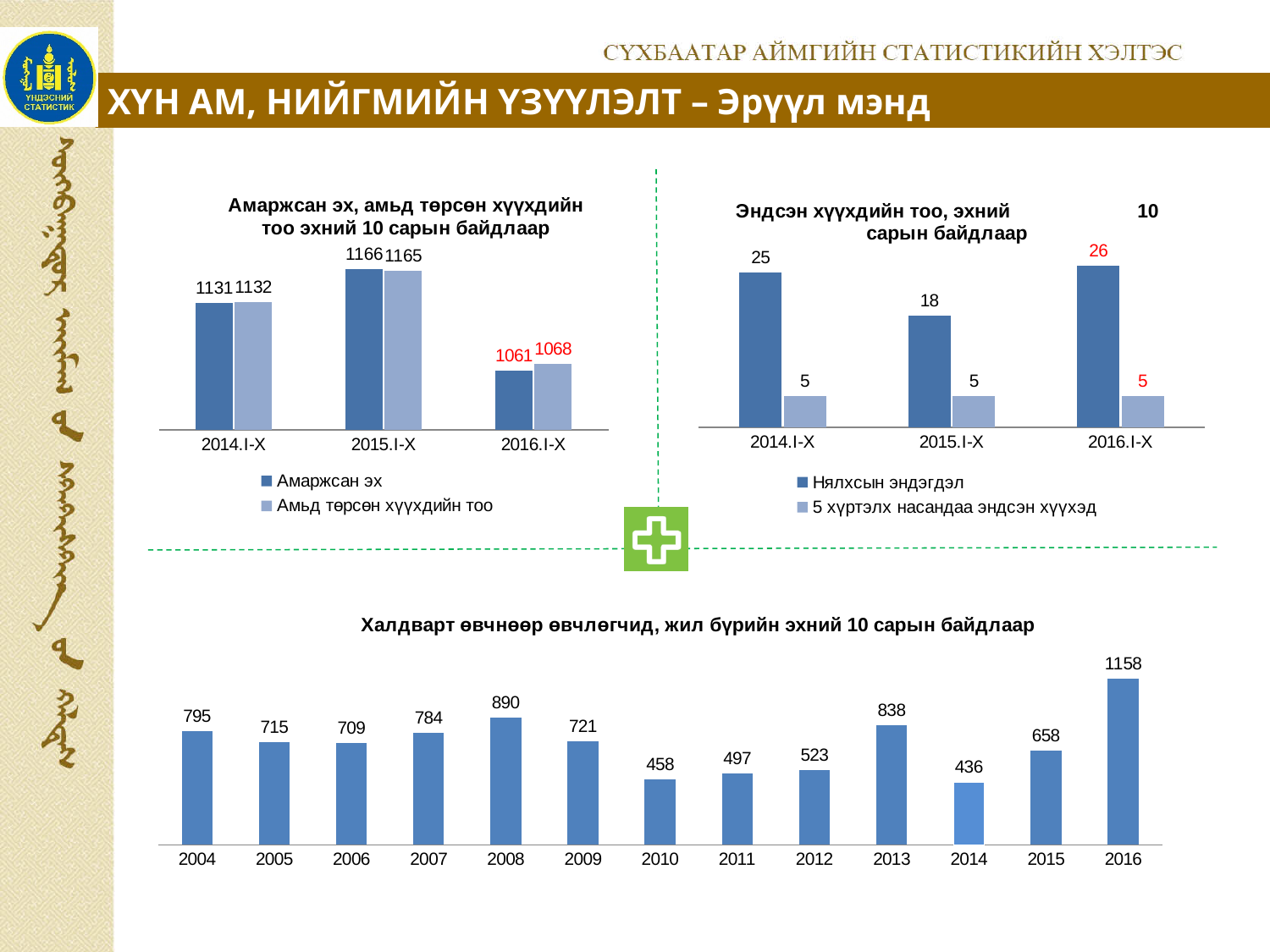
In the top-left chart (Амаржсан эх, амьд төрсөн хүүхдийн тоо), what is the value of Амаржсан эх for 2015.I-X? 1166 In the bottom chart (Халдварт өвчнөөр өвчлөгчид), what is the difference between the values for 2016 and 2015? 500 In the bottom chart (Халдварт өвчнөөр өвчлөгчид), how many years are shown on the x axis? 13 In the top-left chart (Амаржсан эх, амьд төрсөн хүүхдийн тоо), what is the difference between Амьд төрсөн хүүхдийн тоо and Амаржсан эх for 2016.I-X? 7 In the top-right chart (Эндсэн хүүхдийн тоо), which period has the highest value for Нялхсын эндэгдэл? 2016.I-X In the top-left chart (Амаржсан эх, амьд төрсөн хүүхдийн тоо), how many series does the legend list? 2 In the bottom chart (Халдварт өвчнөөр өвчлөгчид), what is the value for 2008? 890 In the top-left chart (Амаржсан эх, амьд төрсөн хүүхдийн тоо), what is the value of Амьд төрсөн хүүхдийн тоо for 2016.I-X? 1068 In the bottom chart (Халдварт өвчнөөр өвчлөгчид), which year has the lowest value? 2014 In the bottom chart (Халдварт өвчнөөр өвчлөгчид), which year has the highest value? 2016 In the top-right chart (Эндсэн хүүхдийн тоо), what is the value of 5 хүртэлх насандаа эндсэн хүүхэд for 2014.I-X? 5 In the top-right chart (Эндсэн хүүхдийн тоо), what is the value of Нялхсын эндэгдэл for 2015.I-X? 18